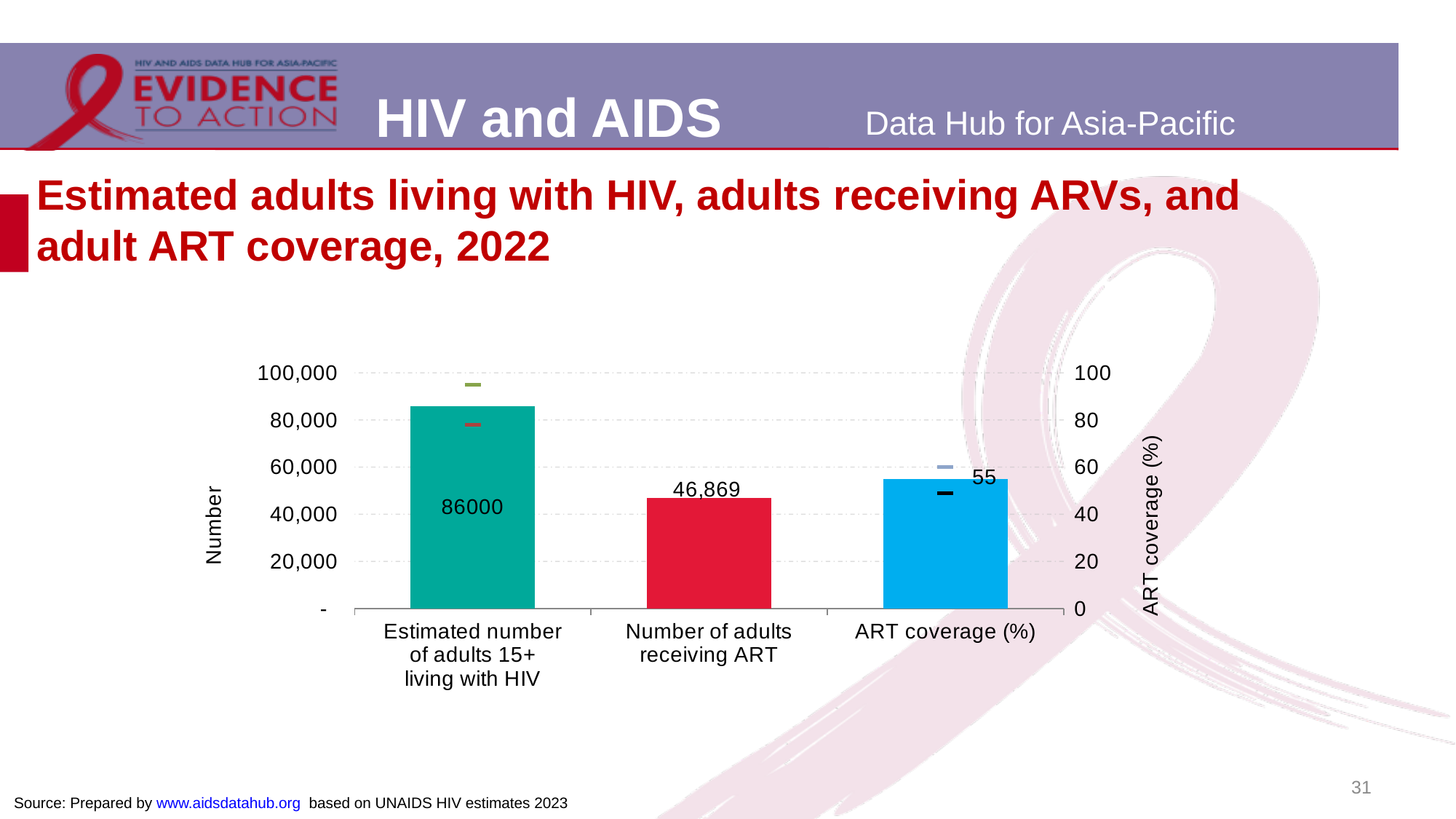
What is the difference between the estimated number of adults 15+ living with HIV and the number of adults receiving ART? 39,131 What is the title of the right-hand vertical axis of the chart? ART coverage (%) How many categories are shown on the x axis of the chart? 3 Is the estimated number of adults 15+ living with HIV greater or less than 80,000? greater Is the number of adults receiving ART greater or less than 60,000? less Which is larger: the estimated number of adults 15+ living with HIV or the number of adults receiving ART? Estimated number of adults 15+ living with HIV What is the title of the left-hand vertical axis of the chart? Number What is the number of adults receiving ART shown on the chart? 46,869 Is the ART coverage (%) value greater or less than 60 on the right-hand axis? less What is the ART coverage (%) value shown on the chart? 55 What is the estimated number of adults 15+ living with HIV shown on the chart? 86000 What kind of chart is shown on the slide? Bar chart